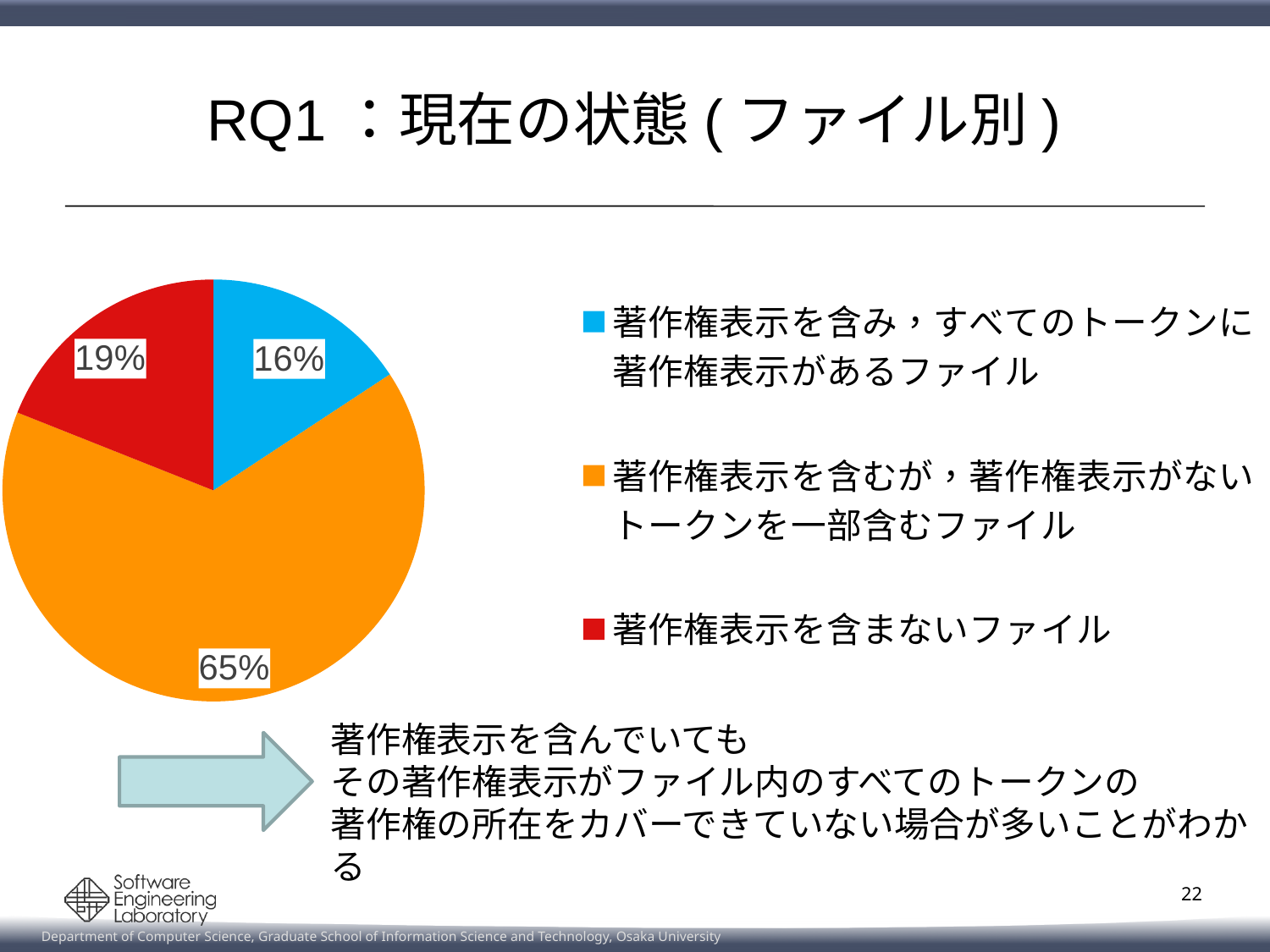
Which category has the largest slice of the pie? 著作権表示を含むが，著作権表示がないトークンを一部含むファイル What colour is the slice for 著作権表示を含まないファイル? Red How many entries does the legend list? 3 What is the difference in percentage points between the 65% slice and the 19% slice? 46 Which is larger: the slice for 著作権表示を含まないファイル or the slice for 著作権表示を含み，すべてのトークンに著作権表示があるファイル? 著作権表示を含まないファイル How many slices does the pie chart have? 3 What percentage is shown for 著作権表示を含むが，著作権表示がないトークンを一部含むファイル? 65% What share of the pie is labelled for 著作権表示を含まないファイル? 19% Which category has the smallest slice of the pie? 著作権表示を含み，すべてのトークンに著作権表示があるファイル What kind of chart is shown on the slide? Pie chart What percentage is shown for 著作権表示を含み，すべてのトークンに著作権表示があるファイル? 16% What colour is the largest slice of the pie? Orange